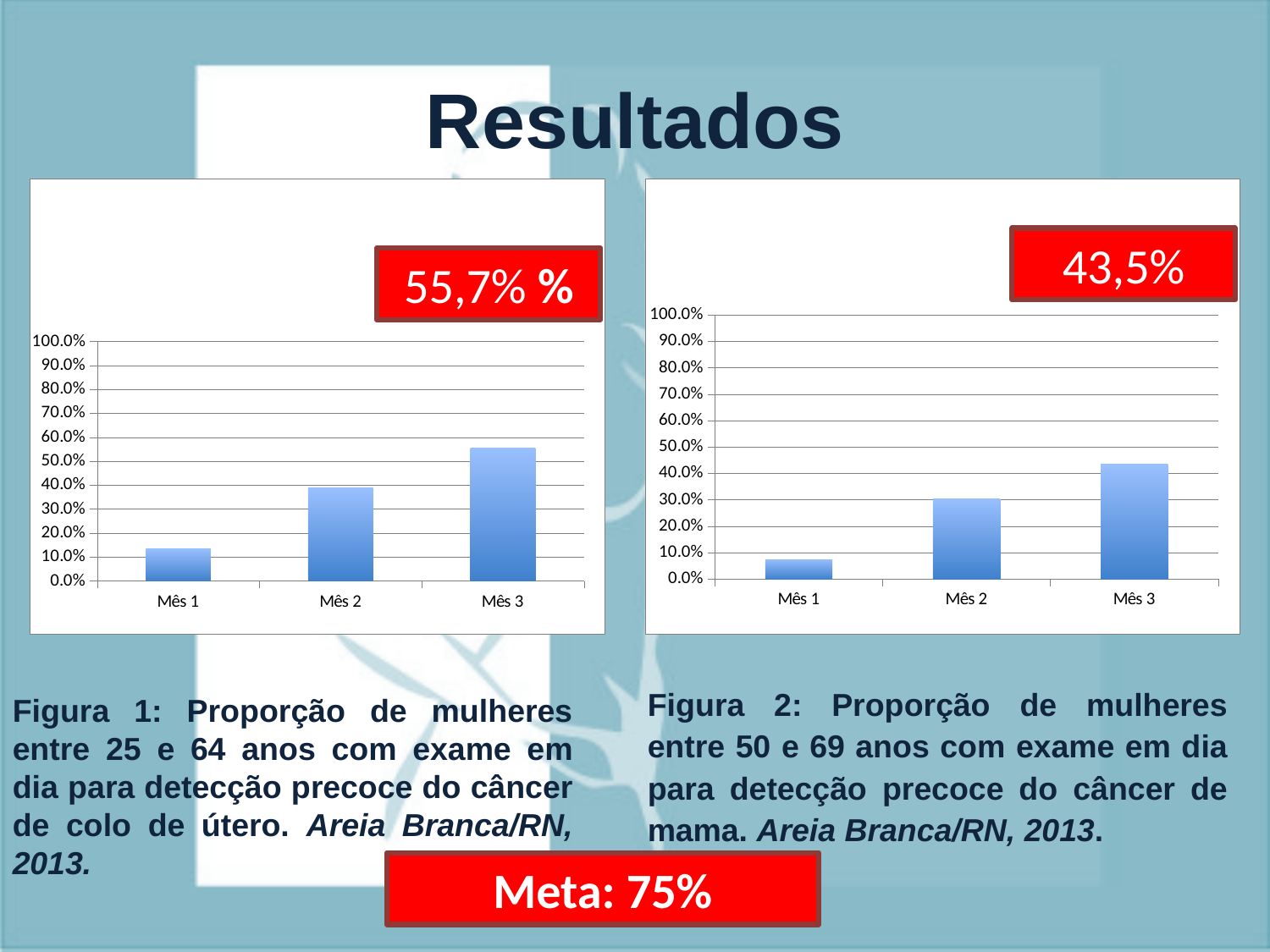
What percentage is shown in the red box above the right chart (Figura 2)? 43,5% In the left chart (Figura 1), do the values rise or fall from Mês 1 to Mês 3? rise What target (Meta) is shown in the red box at the bottom of the slide? 75% In the left chart (Figura 1), which month has the highest value? Mês 3 In the right chart (Figura 2), which is larger, the value for Mês 2 or the value for Mês 3? Mês 3 In the right chart (Figura 2), is the value for Mês 1 greater or less than 10.0%? less How many categories are shown on the x axis of the right chart (Figura 2)? 3 In the left chart (Figura 1), is the value for Mês 3 greater or less than 50.0%? greater In the right chart (Figura 2), which month has the lowest value? Mês 1 What kind of chart is the left chart (Figura 1)? bar chart In the right chart (Figura 2), is the value for Mês 2 greater or less than 20.0%? greater